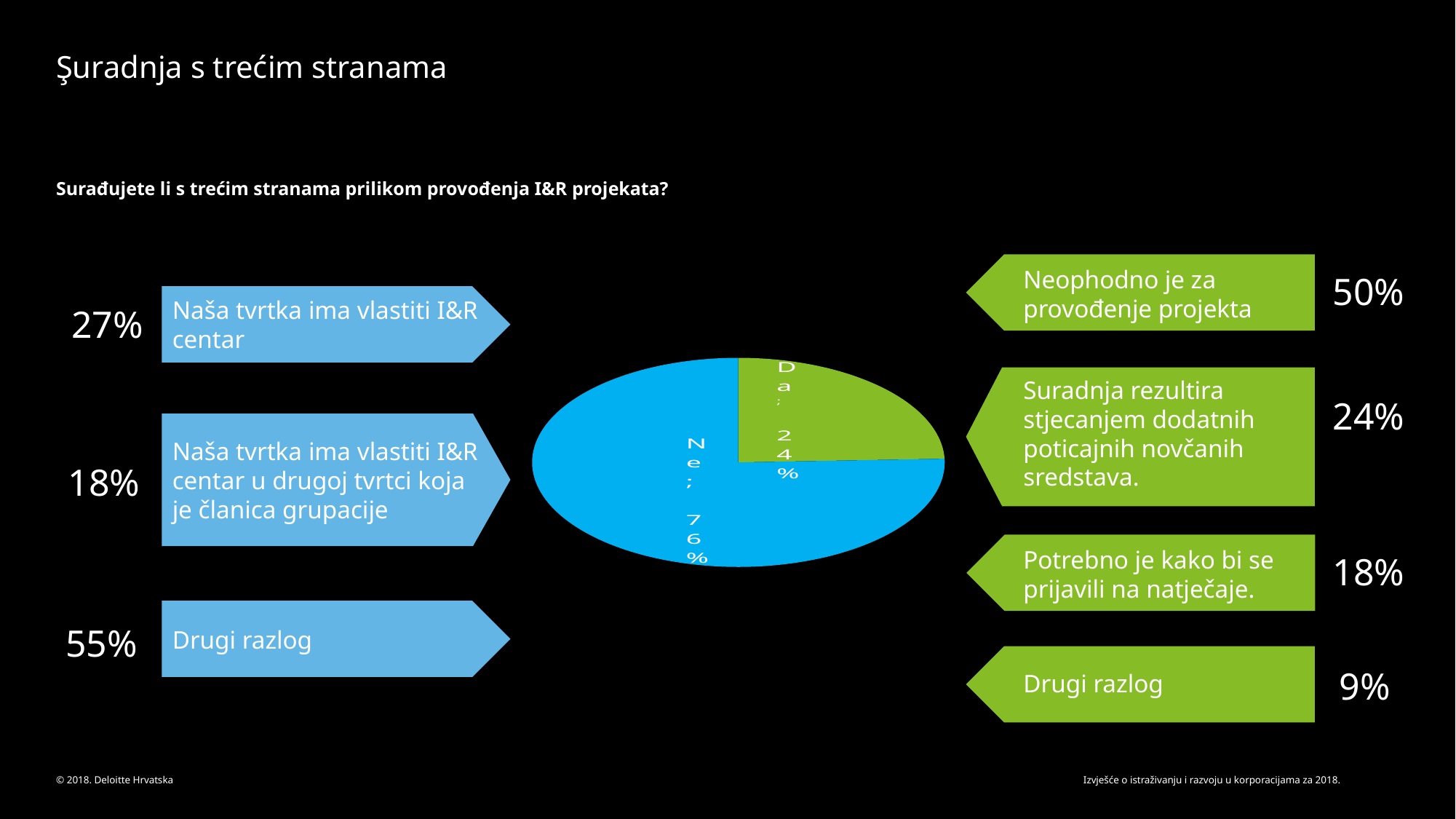
What is the difference in percentage points between the "Ne" and "Da" slices of the pie chart? 52 How many slices does the pie chart have? 2 What is the total of the two slices shown in the pie chart? 100% Which slice of the pie chart is the smallest? Da Is the "Da" slice of the pie chart greater or less than 50%? less Which slice of the pie chart is the largest? Ne What colour is the "Da" slice of the pie chart? green In the pie chart, is the "Ne" slice larger or smaller than the "Da" slice? larger In the pie chart, what share is labelled "Da"? 24% In the pie chart, what share is labelled "Ne"? 76% What colour is the "Ne" slice of the pie chart? blue What kind of chart is shown in the centre of the slide? pie chart